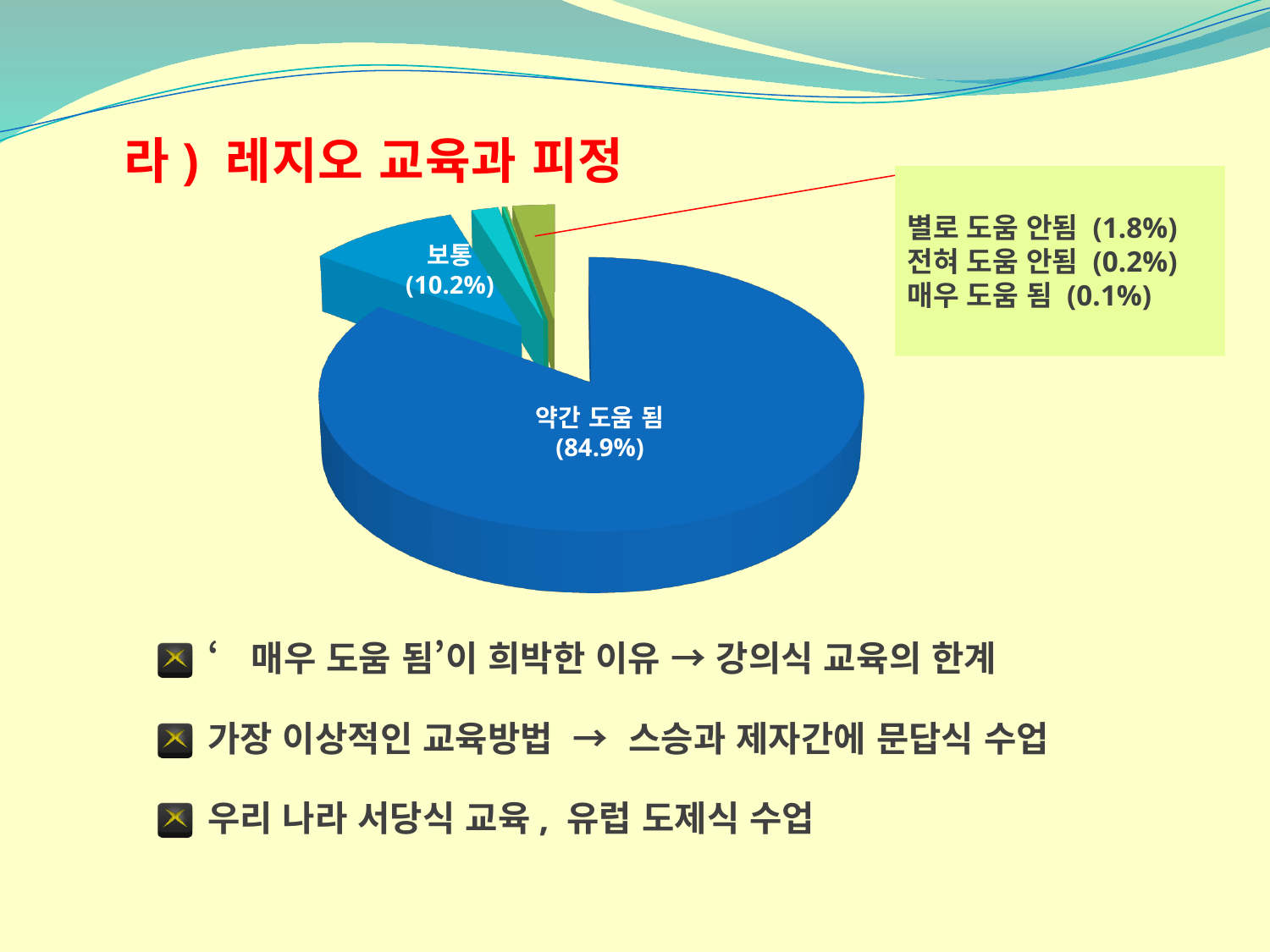
What share of the pie does '약간 도움 됨' have? 84.9% What kind of chart is shown on the slide? Pie chart Which category has the smallest share of the pie? 매우 도움 됨 What percentage is shown for '전혀 도움 안됨'? 0.2% Which category has the largest share of the pie? 약간 도움 됨 What percentage is shown for '별로 도움 안됨'? 1.8% Which is larger, the share for '별로 도움 안됨' or the share for '전혀 도움 안됨'? 별로 도움 안됨 What percentage is shown for '매우 도움 됨'? 0.1% What is the difference in percentage points between '약간 도움 됨' and '보통'? 74.7 What share of the pie does '보통' have? 10.2% What is the title of the slide containing the pie chart? 라) 레지오 교육과 피정